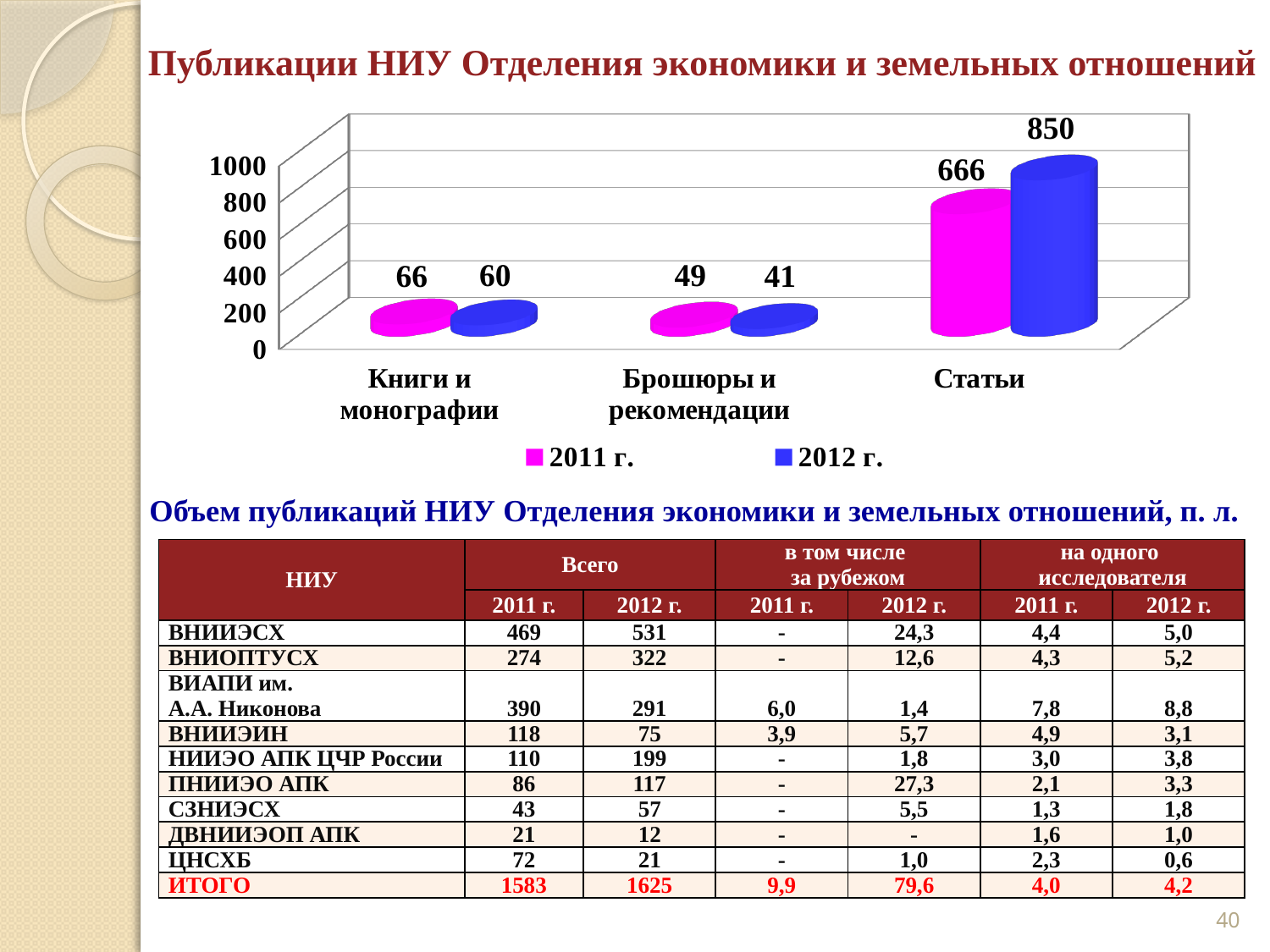
How many series does the chart legend list? 2 Which category has the highest value in 2011 г.? Статьи Is the value for Статьи in 2011 г. greater or less than 600? greater What kind of chart is shown on the slide? bar chart Which category has the lowest value in 2012 г.? Брошюры и рекомендации What is the value for Книги и монографии in 2011 г.? 66 What is the value for Брошюры и рекомендации in 2012 г.? 41 What is the difference between the 2011 г. and 2012 г. values for Книги и монографии? 6 What is the difference between the 2012 г. and 2011 г. values for Статьи? 184 Which is larger for Брошюры и рекомендации: the 2011 г. value or the 2012 г. value? 2011 г. How many categories are shown on the x axis of the chart? 3 What is the value for Статьи in 2012 г.? 850